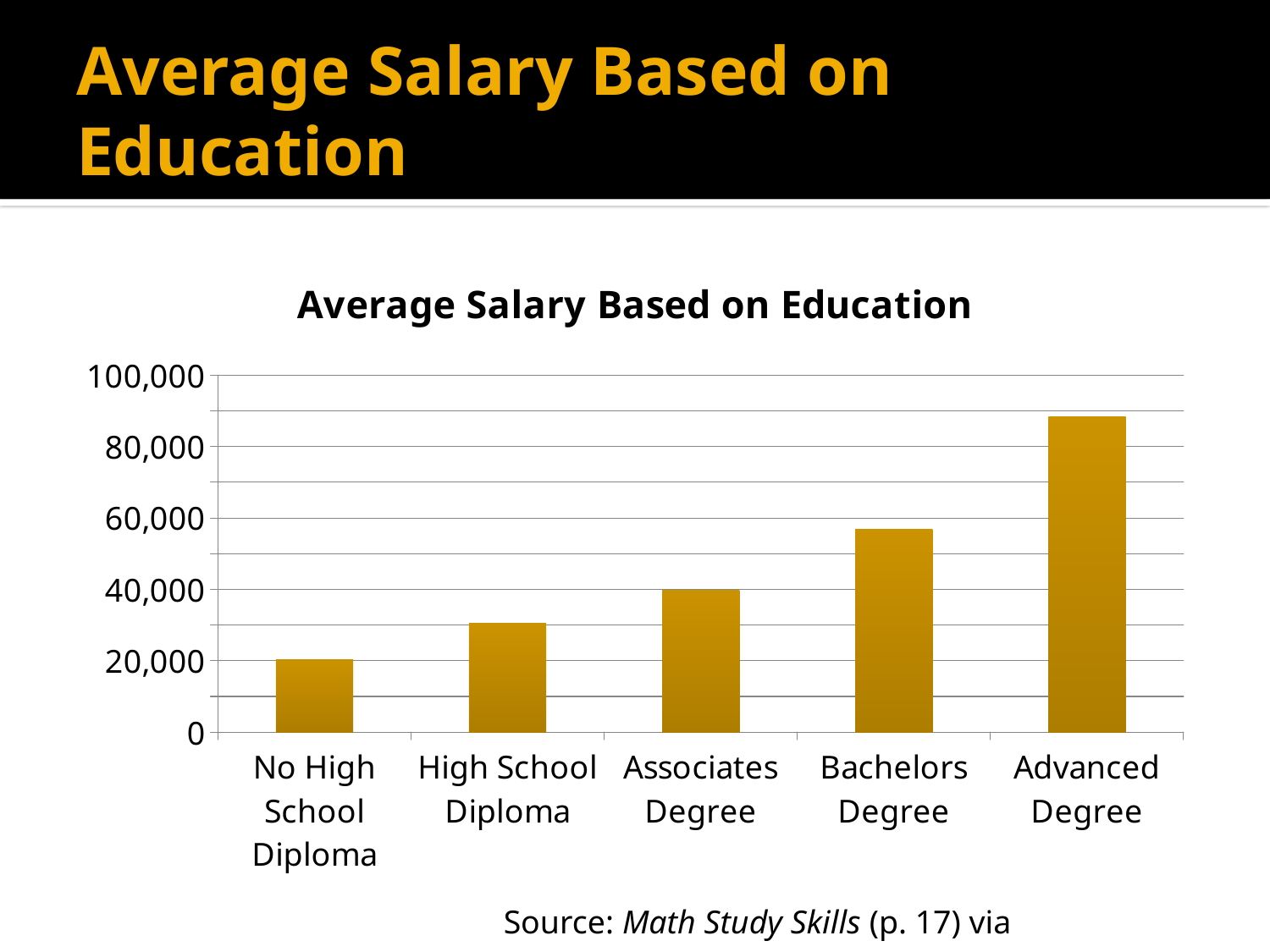
Is the value for Bachelors Degree greater or less than 40,000? greater Do the values rise or fall moving from left to right along the x axis? rise Is the value for No High School Diploma greater or less than 40,000? less How many education categories are shown on the x axis? 5 What is the title of the chart? Average Salary Based on Education Is the value for Bachelors Degree greater or less than 60,000? less Which is larger, the value for Associates Degree or the value for Bachelors Degree? Bachelors Degree Which education category has the highest average salary? Advanced Degree What type of chart is shown on the slide? bar chart Which education category has the lowest average salary? No High School Diploma